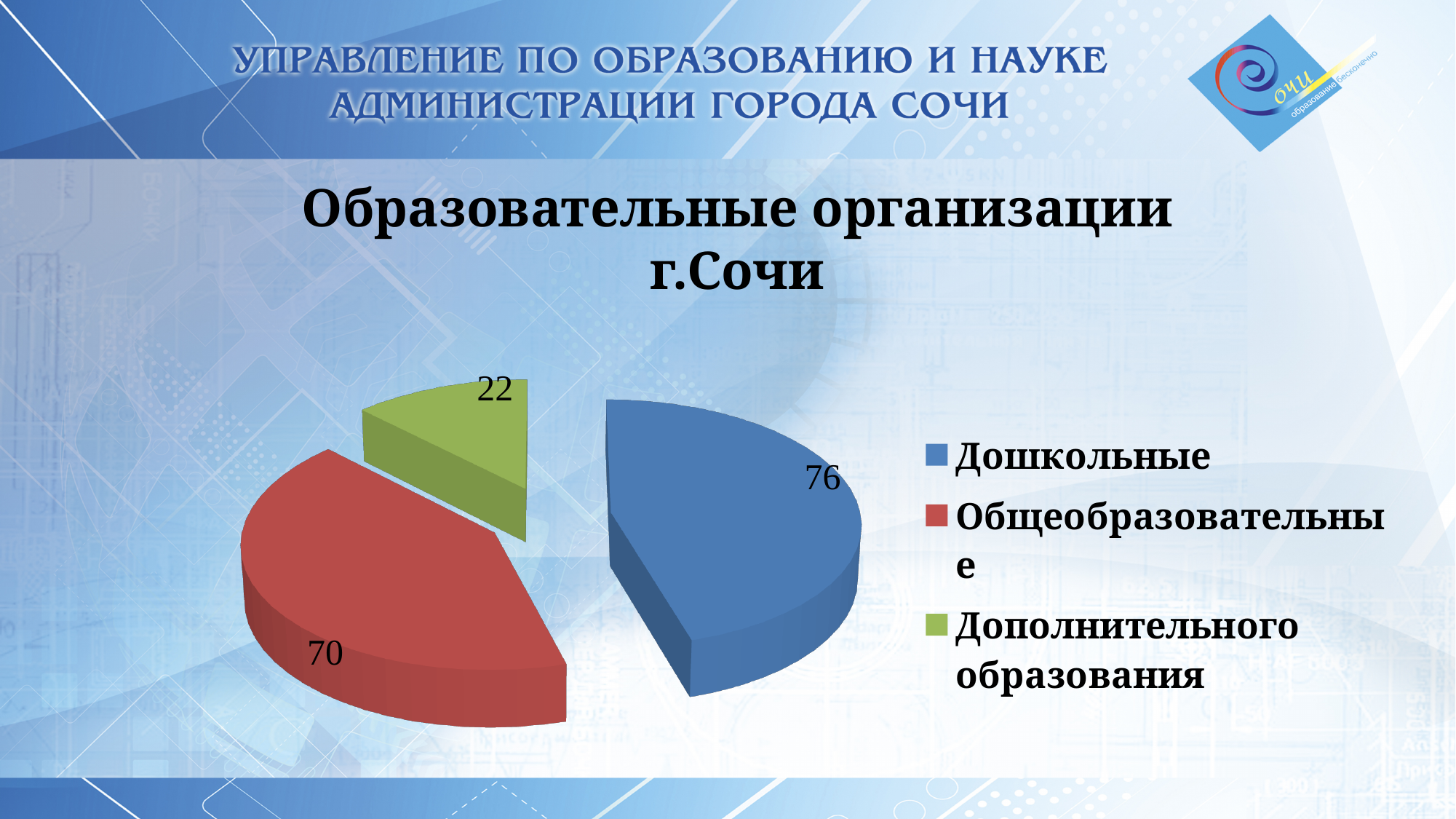
What is the value for Дошкольные? 76 What type of chart is shown on the slide? Pie chart What colour is the slice for Дополнительного образования? Green How many slices does the pie chart have? 3 Which is larger, the value for Общеобразовательные or the value for Дополнительного образования? Общеобразовательные What is the value for Общеобразовательные? 70 What is the total of all the values shown in the pie chart? 168 Which category has the largest slice? Дошкольные What is the difference between the values for Дошкольные and Общеобразовательные? 6 Which category has the smallest slice? Дополнительного образования What is the difference between the values for Общеобразовательные and Дополнительного образования? 48 What is the value for Дополнительного образования? 22